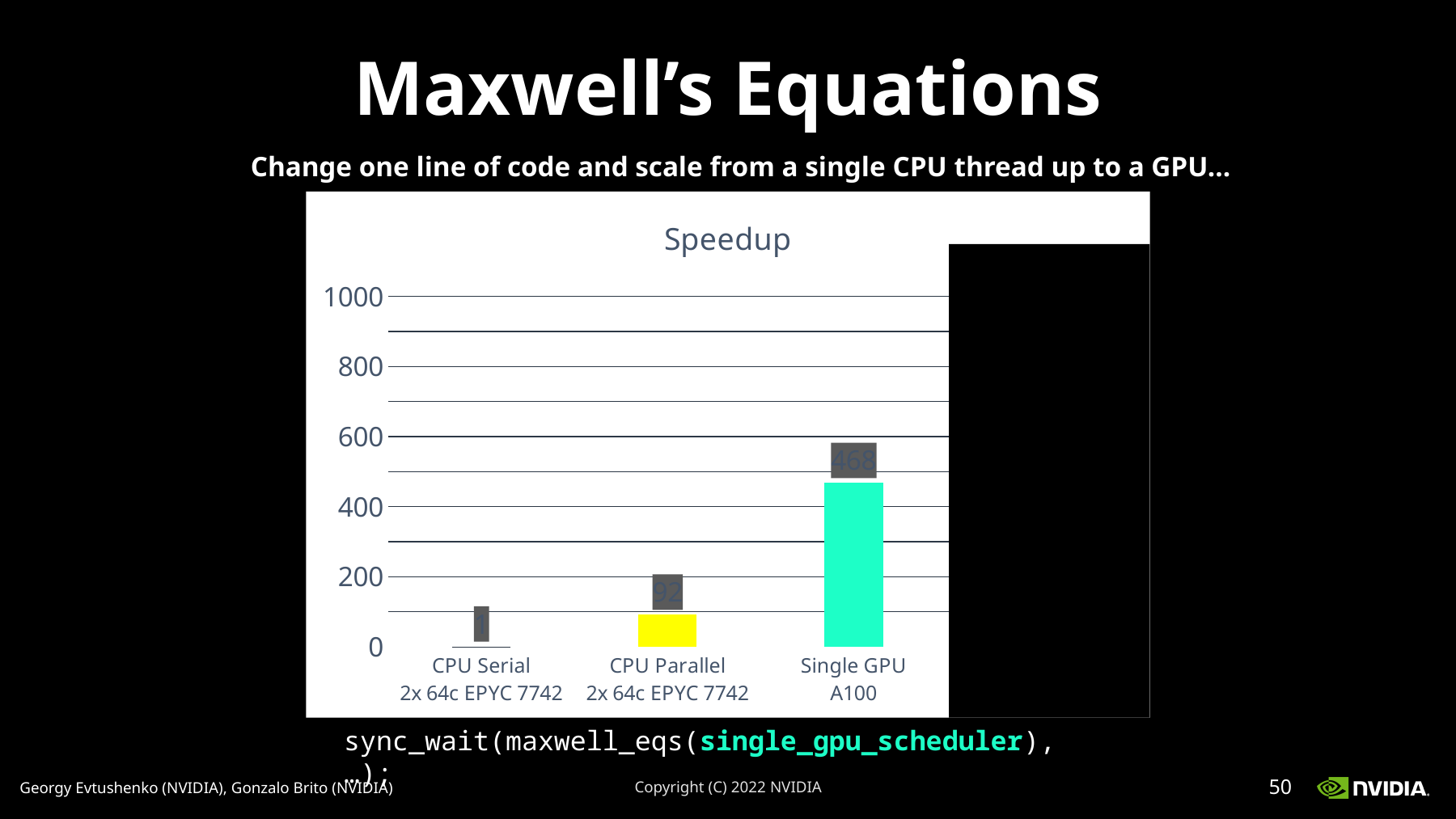
What is the difference in speedup between Single GPU A100 and CPU Parallel? 376 What is the speedup value for CPU Parallel 2x 64c EPYC 7742? 92 Do the speedup values rise or fall from left to right along the x axis? rise What kind of chart is shown on the slide? bar chart What is the speedup value for CPU Serial 2x 64c EPYC 7742? 1 What is the speedup value for Single GPU A100? 468 Which category has the lowest speedup? CPU Serial 2x 64c EPYC 7742 How many categories are plotted in the Speedup chart? 3 What is the title of the chart? Speedup Is the speedup for Single GPU A100 greater or less than 400? greater Which has a larger speedup, CPU Parallel or Single GPU A100? Single GPU A100 Which category has the highest speedup? Single GPU A100